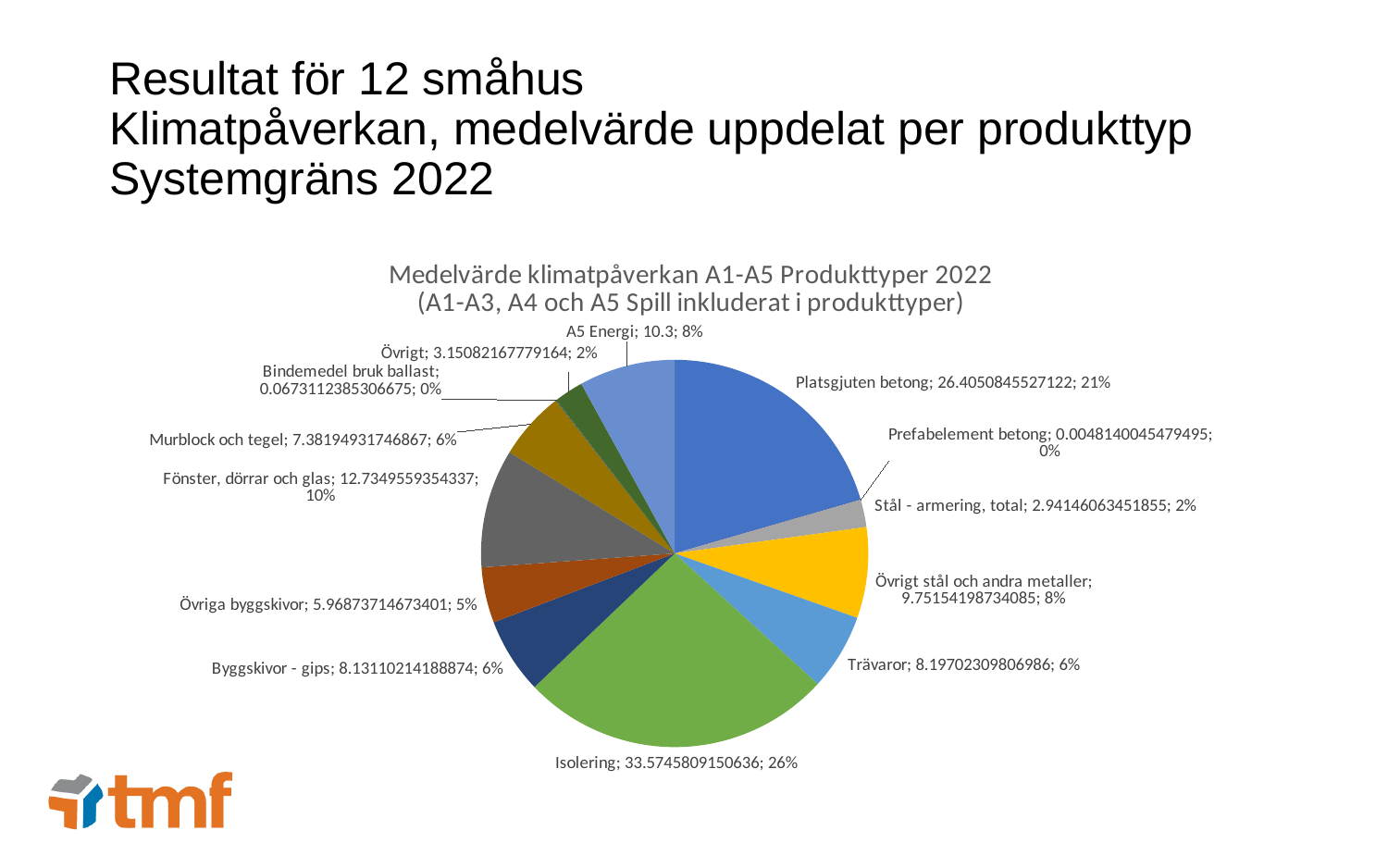
Which category has the largest share of the pie? Isolering What share of the pie does Platsgjuten betong account for? 21% What is the difference in percentage points between the shares of Isolering and Platsgjuten betong? 5% Which has a larger share: Trävaror or Övriga byggskivor? Trävaror How many categories (slices) does the pie chart have? 13 What is the value shown for A5 Energi? 10.3 What kind of chart is shown on the slide? pie chart What percentage is shown for Övrigt stål och andra metaller? 8% Which category has the smallest value in the pie chart? Prefabelement betong What percentage is shown for Fönster, dörrar och glas? 10% What is the first line of the chart's title? Medelvärde klimatpåverkan A1-A5 Produkttyper 2022